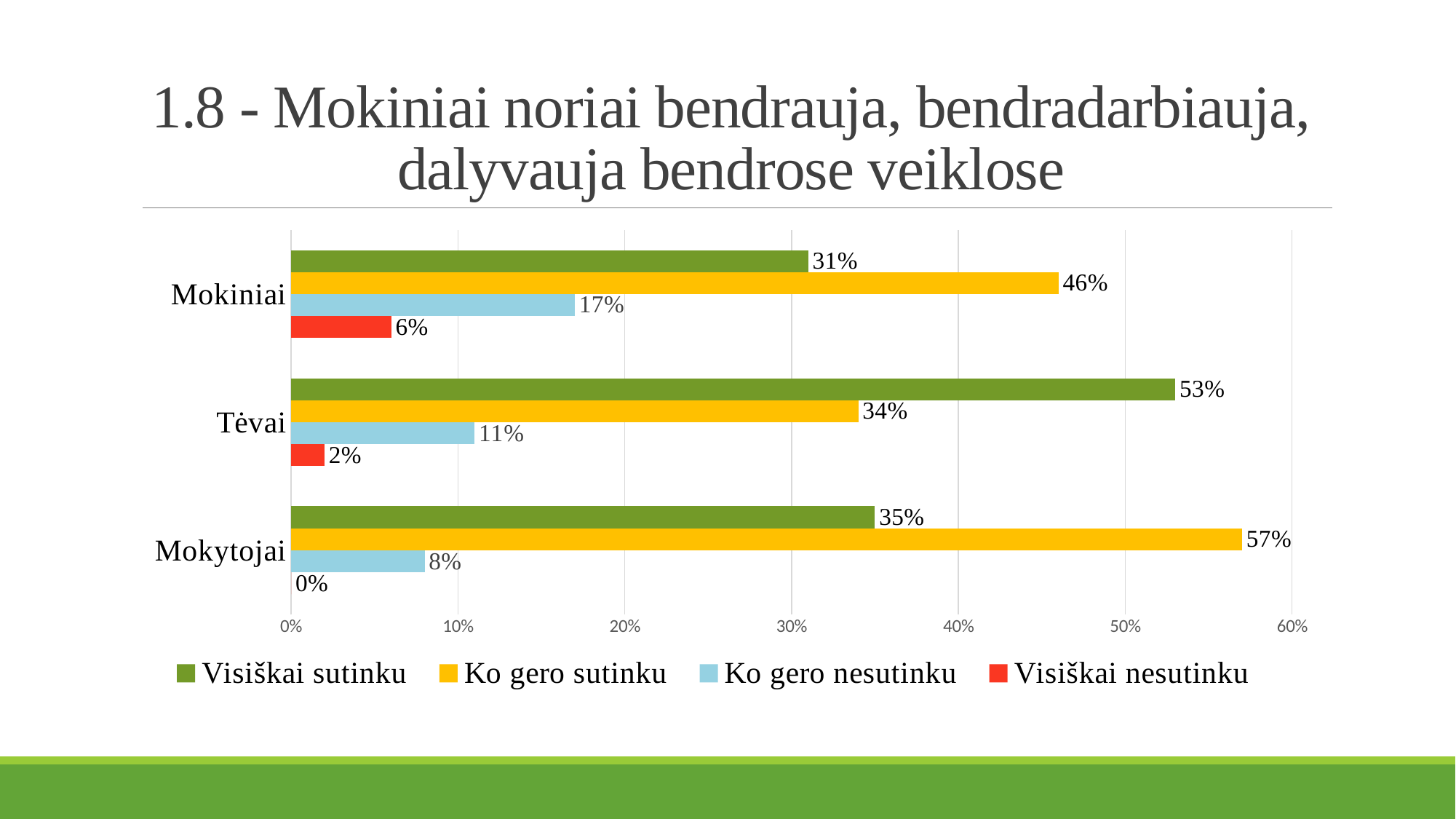
What colour represents the "Visiškai nesutinku" series? Red Which category has the highest value for "Visiškai sutinku"? Tėvai What kind of chart is shown on the slide? Bar chart What is the value for "Visiškai sutinku" for Tėvai? 53% How many categories are shown on the vertical axis? 3 Which is larger for Mokiniai: "Visiškai sutinku" or "Ko gero sutinku"? Ko gero sutinku What is the value for "Visiškai nesutinku" for Mokytojai? 0% How many series does the legend list? 4 What is the value for "Ko gero nesutinku" for Mokiniai? 17% What is the value for "Ko gero sutinku" for Mokytojai? 57% Which category has the lowest value for "Ko gero nesutinku"? Mokytojai What is the difference between the "Ko gero sutinku" values for Mokytojai and Tėvai? 23%